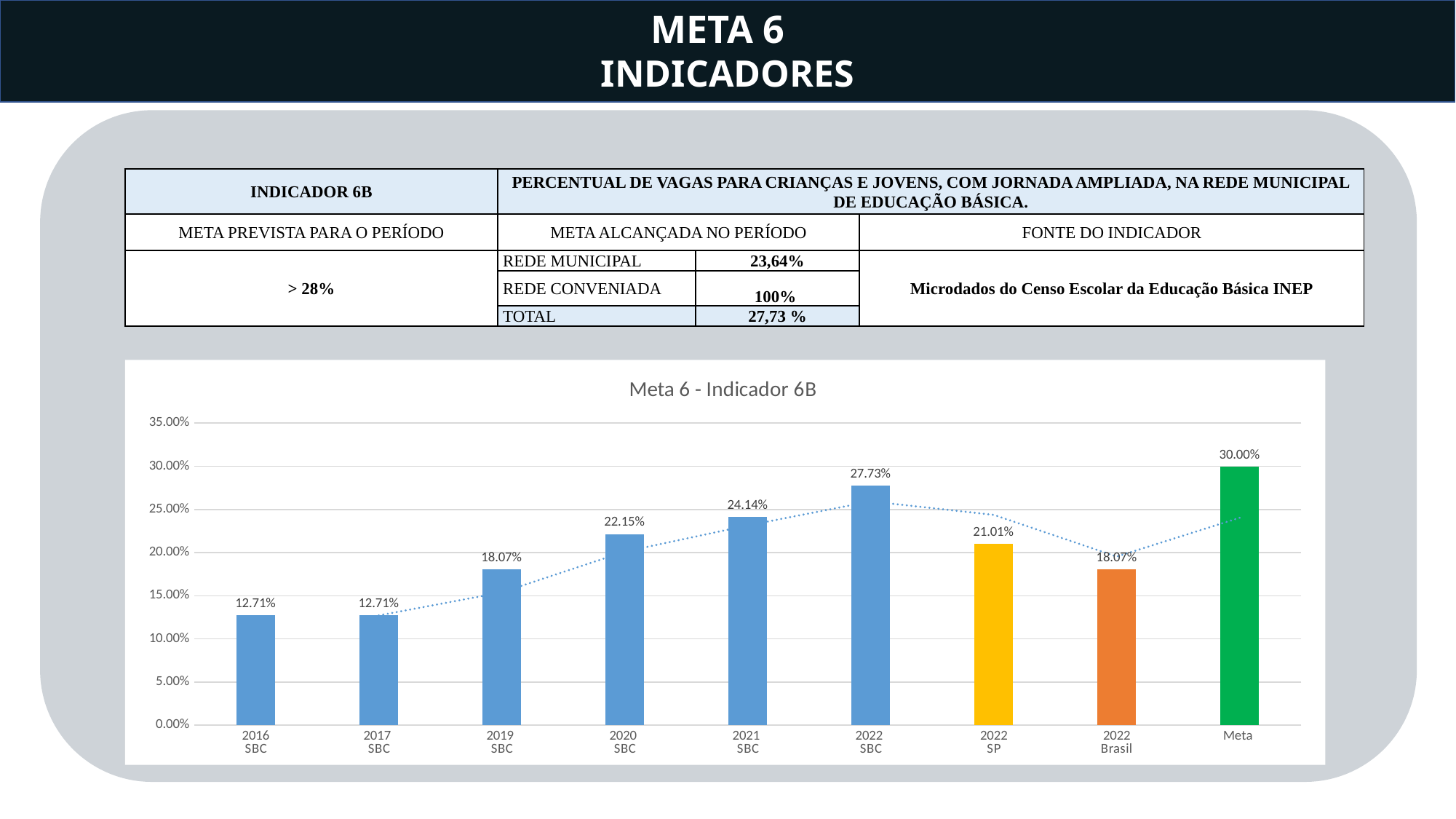
What is the value for 2022 Brasil? 18.07% Which is larger, the value for 2022 SP or the value for 2022 Brasil? 2022 SP What is the value for the Meta bar? 30.00% Which category has the highest value? Meta What is the value for 2022 SBC? 27.73% What is the value for 2022 SP? 21.01% What is the difference between the Meta value and the 2022 SBC value? 2.27% Which SBC year has the lowest value? 2016 SBC and 2017 SBC (12.71%) Is the value for 2021 SBC greater or less than 25.00%? less How many bars are shown in the chart? 9 Do the SBC values rise or fall from 2016 to 2022? Rise What kind of chart is shown on the slide? Bar chart